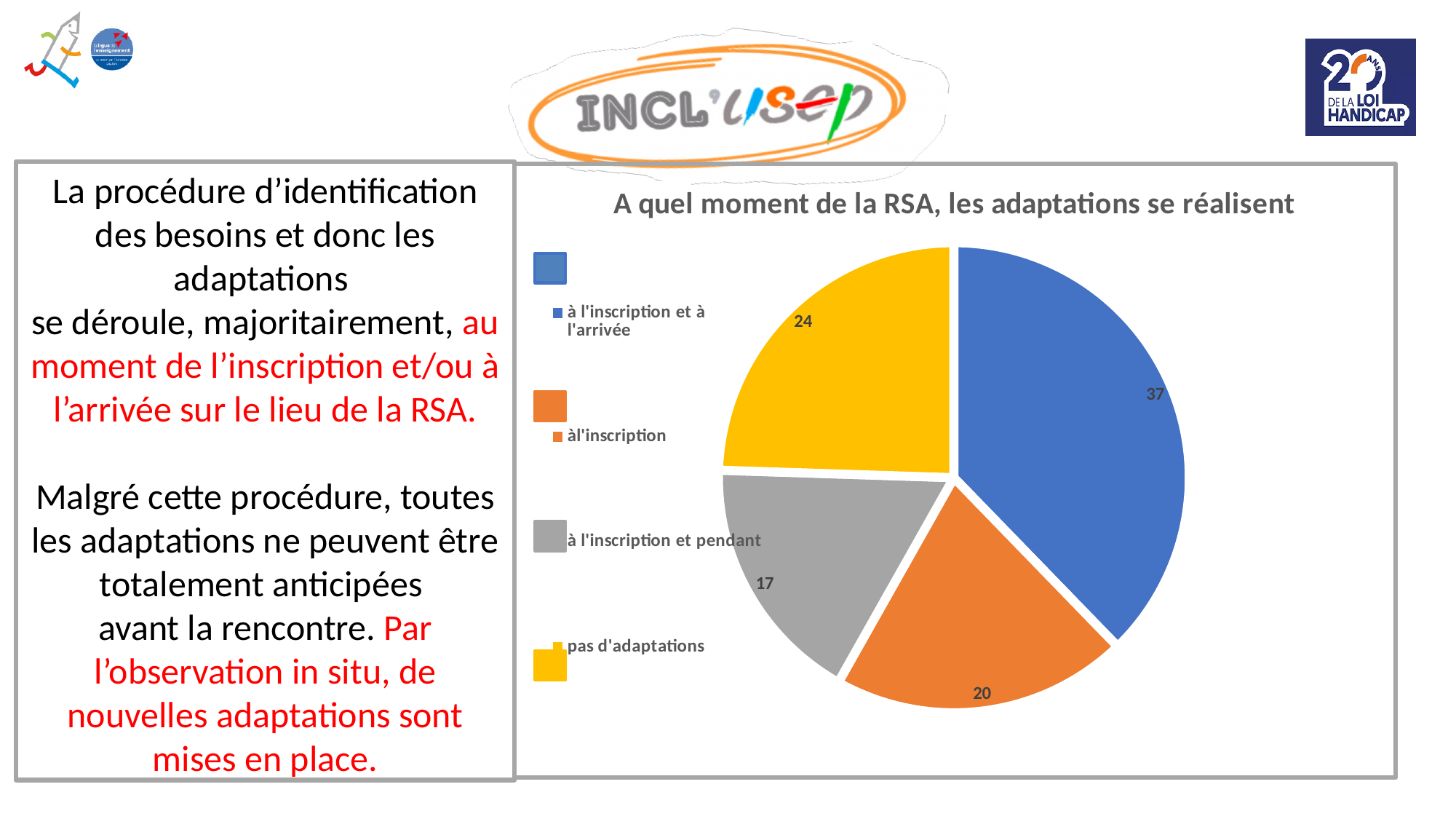
What is the value for "à l'inscription et pendant"? 17 Which is larger, the value for "à l'inscription" or the value for "pas d'adaptations"? pas d'adaptations What is the title of the chart? A quel moment de la RSA, les adaptations se réalisent What is the value for "pas d'adaptations"? 24 What kind of chart is shown on the slide? pie chart How many categories does the pie chart have? 4 Which category has the smallest slice of the pie? à l'inscription et pendant What is the value for "à l'inscription"? 20 What colour is the slice for "pas d'adaptations"? yellow Which category has the largest slice of the pie? à l'inscription et à l'arrivée What is the value for "à l'inscription et à l'arrivée"? 37 What is the difference between the values for "à l'inscription et à l'arrivée" and "pas d'adaptations"? 13